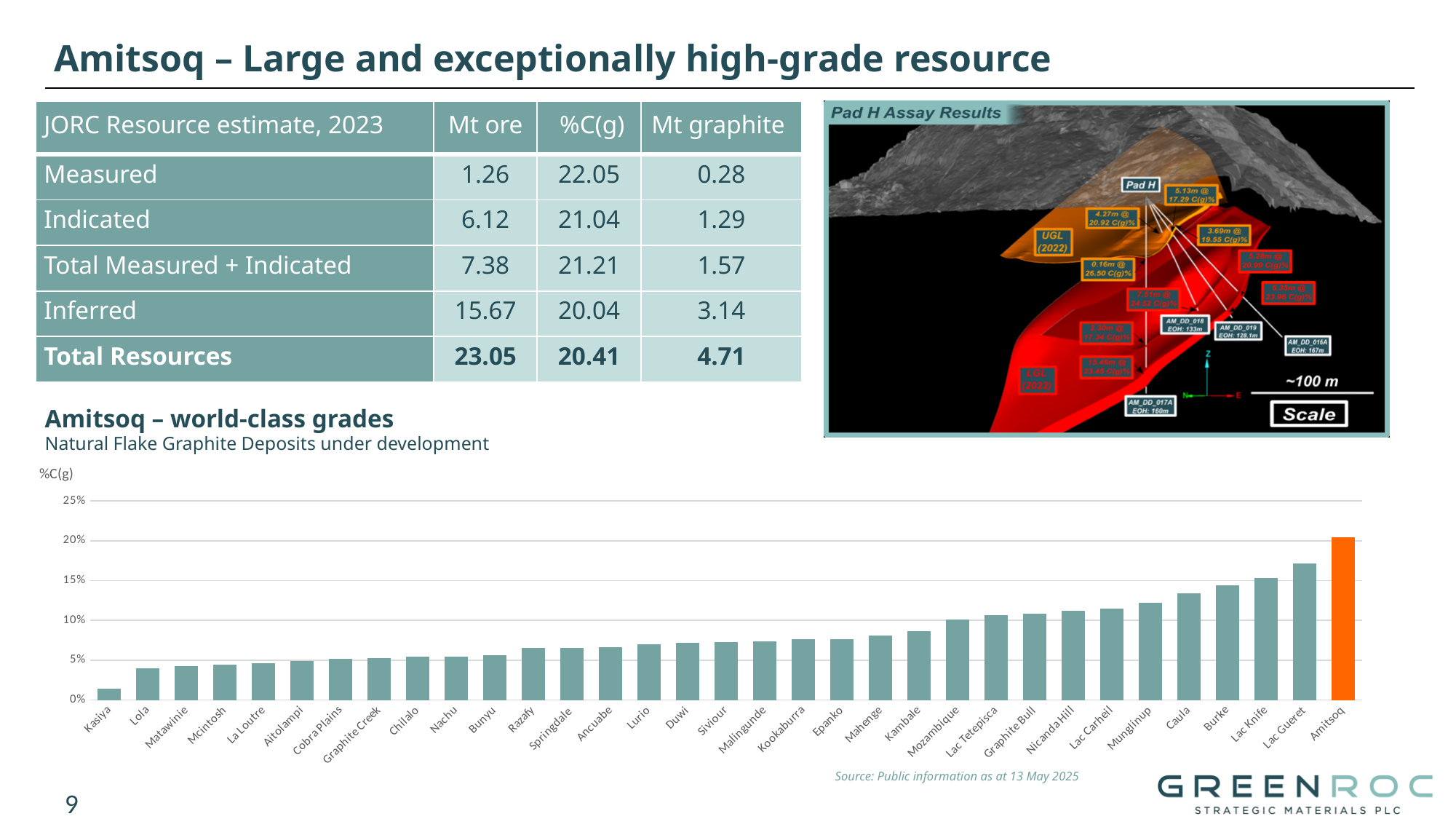
How many deposits are plotted in the bar chart? 33 Is the value for Kambale greater or less than 10%? less What kind of chart is shown at the bottom of the slide? bar chart Do the bar values rise or fall moving from left to right along the x axis? rise Which deposit has the lowest %C(g) grade in the bar chart? Kasiya What colour is the Amitsoq bar in the chart? orange Which deposit has the highest %C(g) grade in the bar chart? Amitsoq Which has the larger %C(g) grade, Amitsoq or Lac Gueret? Amitsoq Is the value for Amitsoq greater or less than 20%? greater Is the value for Lac Gueret greater or less than 15%? greater